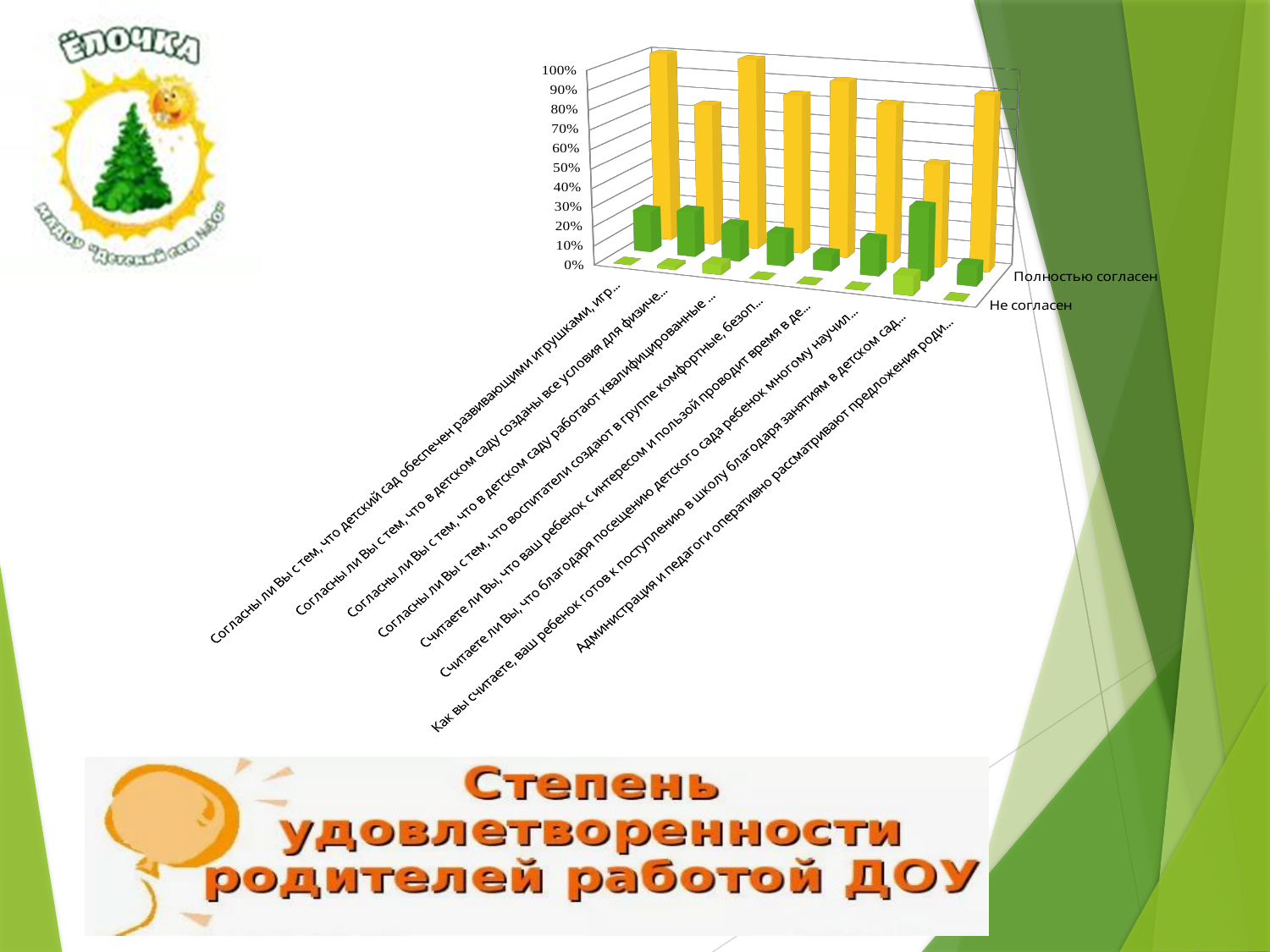
For 'Согласны ли Вы с тем, что детский сад обеспечен развивающими игрушками...', which is larger: 'Полностью согласен' or 'Не согласен'? Полностью согласен Is the 'Не согласен' value for 'Администрация и педагоги оперативно рассматривают предложения роди...' greater or less than 30%? less Which legend entry is listed first in the chart's legend? Полностью согласен How many categories (questions) are plotted along the x axis of the chart? 8 Is the 'Полностью согласен' value for 'Как вы считаете, ваш ребенок готов к поступлению в школу...' greater or less than 70%? less Which category has the lowest 'Полностью согласен' bar? Как вы считаете, ваш ребенок готов к поступлению в школу благодаря занятиям в детском сад... What is the highest tick value shown on the vertical axis of the chart? 100% Is the 'Полностью согласен' value for 'Согласны ли Вы с тем, что детский сад обеспечен развивающими игрушками...' greater or less than 50%? greater What kind of chart is shown on the slide? bar chart